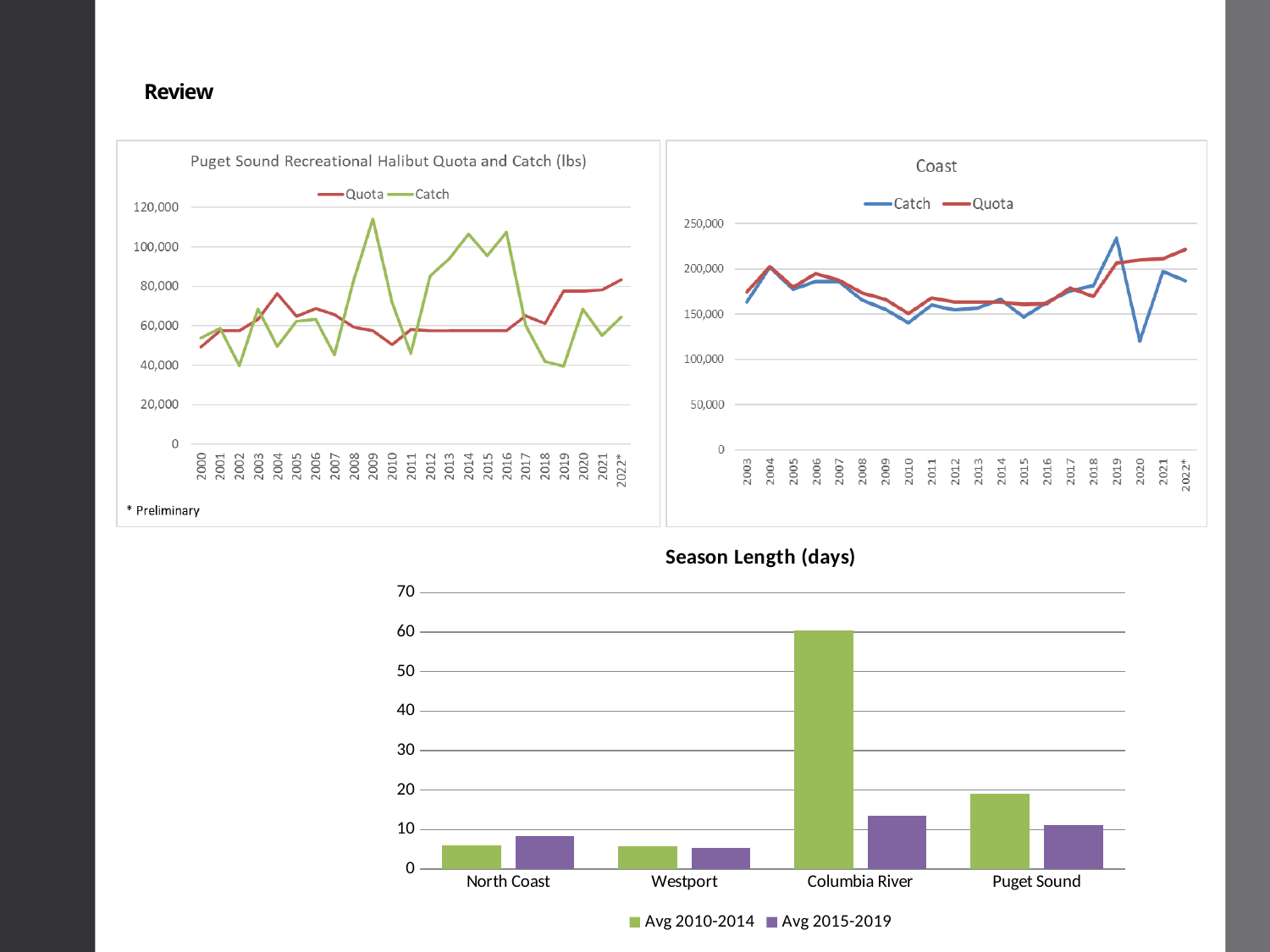
How many categories are shown on the x axis of the Season Length (days) chart? 4 In the Coast chart, is the Catch value for 2020 greater or less than 150,000? less What kind of chart is the Puget Sound Recreational Halibut Quota and Catch (lbs) chart? line chart In the Season Length (days) chart, is the Avg 2015-2019 value for Westport greater or less than 10? less In the Coast chart, which year has the highest Catch? 2019 In the Season Length (days) chart, which category has the highest Avg 2010-2014 value? Columbia River In the Puget Sound Recreational Halibut Quota and Catch (lbs) chart, is the Catch value for 2009 greater or less than 100,000? greater How many series does the legend of the Season Length (days) chart list? 2 In the Season Length (days) chart, which is larger for Puget Sound: Avg 2010-2014 or Avg 2015-2019? Avg 2010-2014 In the Puget Sound Recreational Halibut Quota and Catch (lbs) chart, which year has the highest Catch? 2009 What kind of chart is the Season Length (days) chart? bar chart